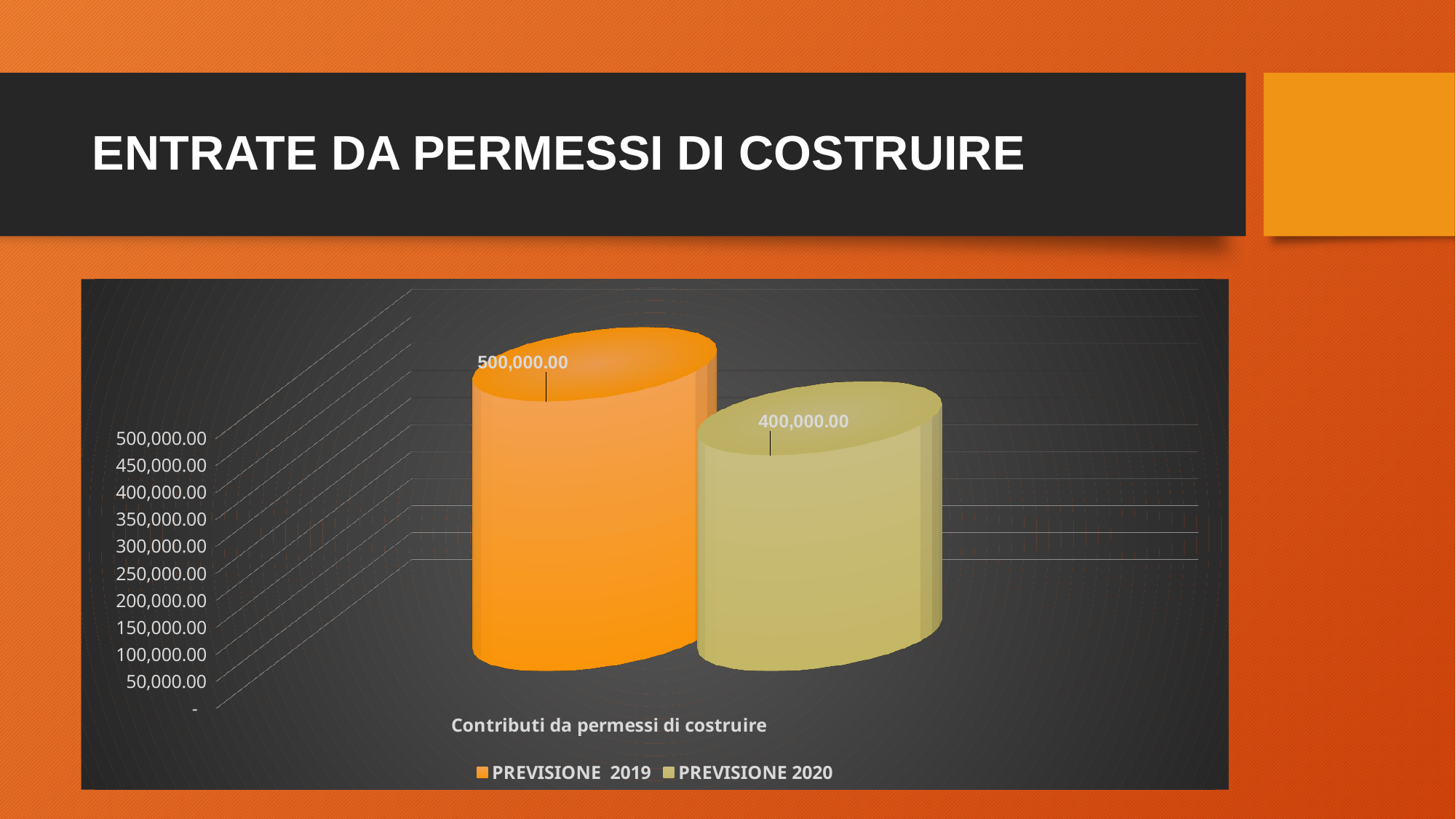
What colour is the bar for PREVISIONE 2019? Orange How many categories are shown on the x axis? 1 Which series has the lowest value? PREVISIONE 2020 What kind of chart is shown on the slide? Bar chart What is the value for PREVISIONE 2020? 400,000.00 What is the category label shown on the x axis? Contributi da permessi di costruire Which series has the higher value, PREVISIONE 2019 or PREVISIONE 2020? PREVISIONE 2019 What is the difference between the PREVISIONE 2019 and PREVISIONE 2020 values? 100,000.00 What is the value for PREVISIONE 2019? 500,000.00 How many series does the legend list? 2 Is the value for PREVISIONE 2020 greater or less than 450,000.00? less